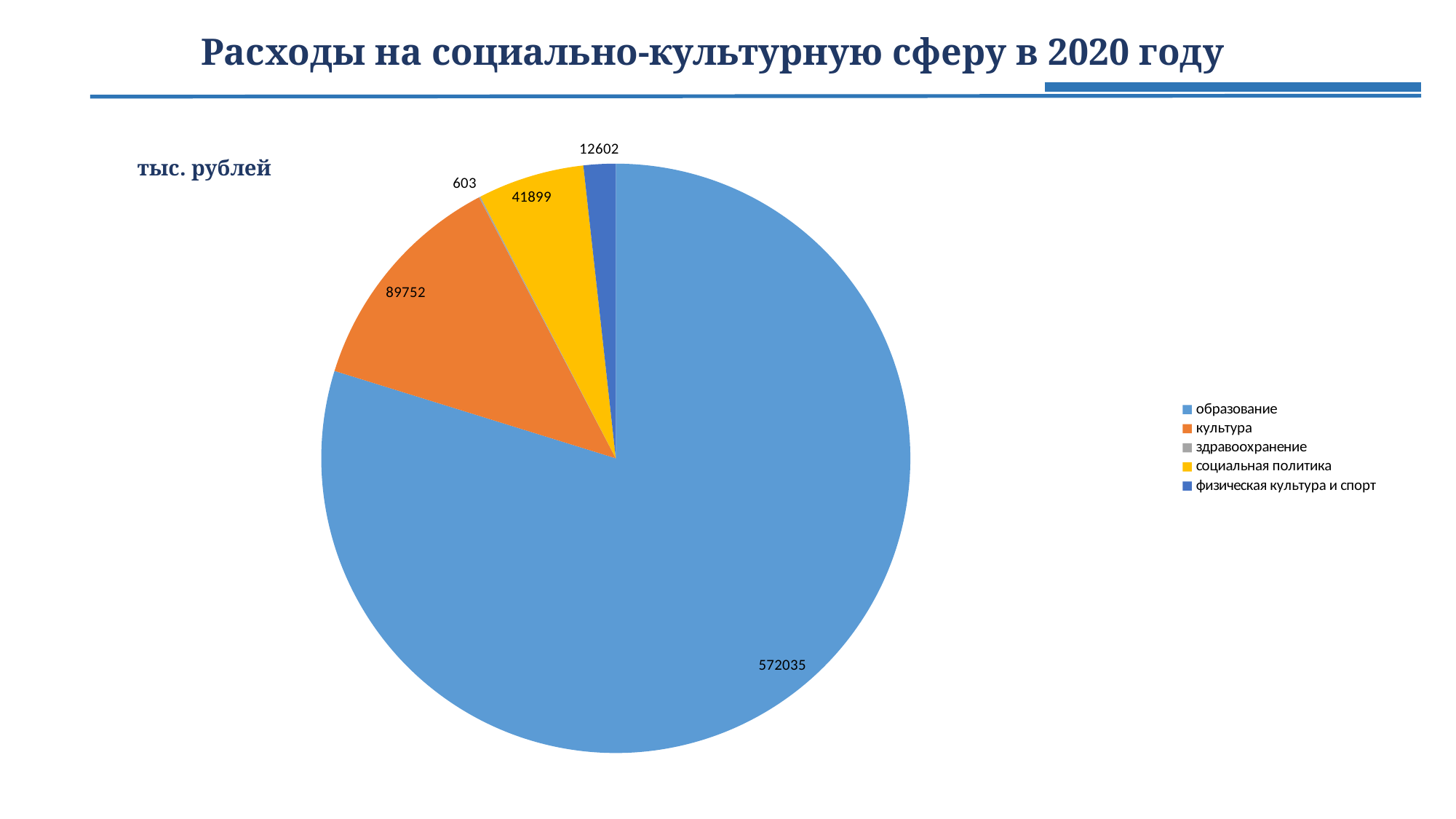
How many categories does the legend list? 5 What is the value for культура? 89752 In what units are the values on the chart given? тыс. рублей Which category has the smallest slice of the pie? здравоохранение Which category has the largest slice of the pie? образование What is the value for социальная политика? 41899 What kind of chart is shown on the slide? pie chart What is the value for физическая культура и спорт? 12602 What is the difference between the values for образование and культура? 482283 Which is larger, the value for социальная политика or the value for физическая культура и спорт? социальная политика What is the value for образование? 572035 What is the value for здравоохранение? 603